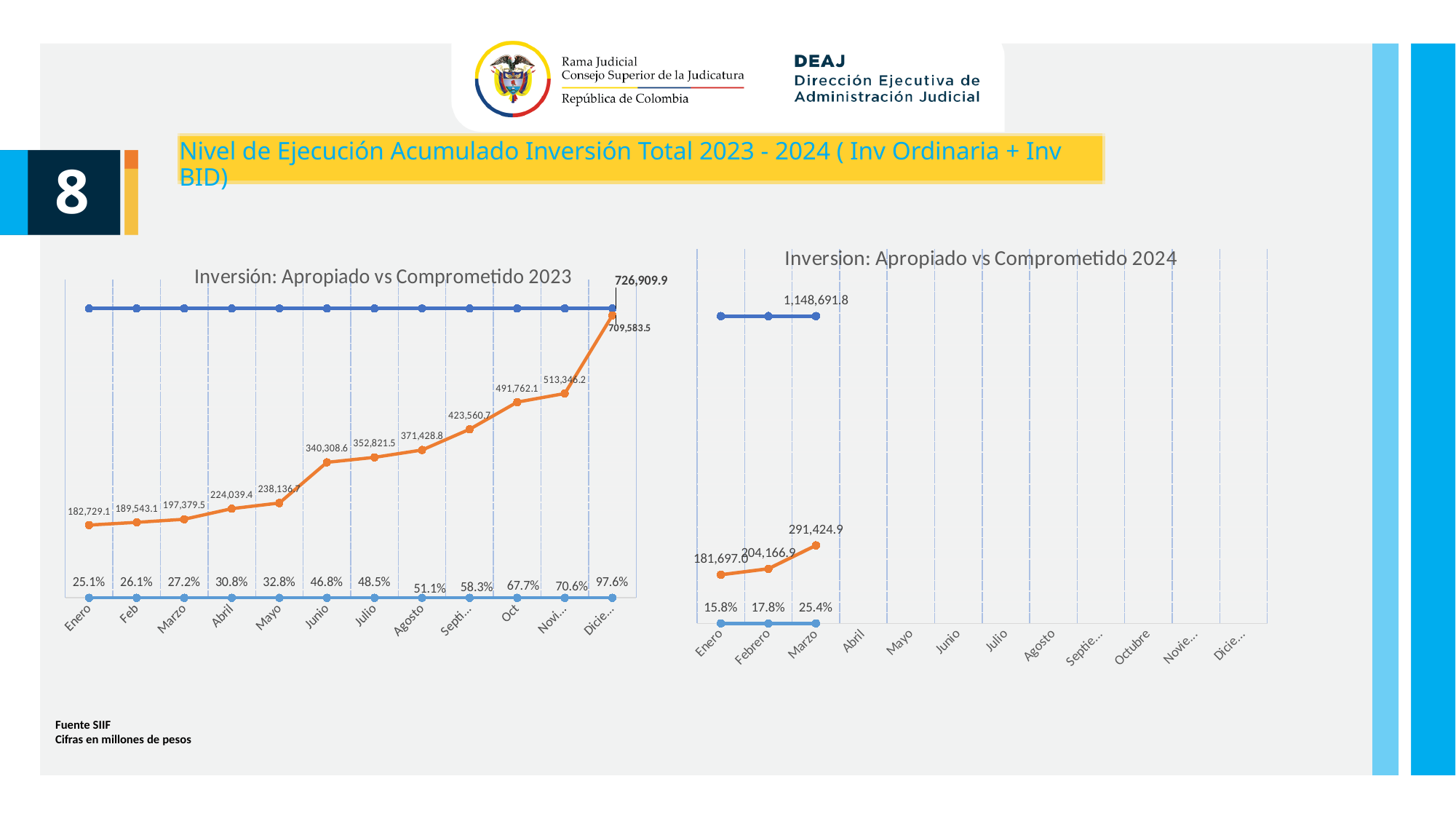
In the 'Inversión: Apropiado vs Comprometido 2023' chart, which month has the lowest value on the orange line? Enero In the 'Inversión: Apropiado vs Comprometido 2023' chart, what is the value labelled at the top of the blue line in December? 726,909.9 What type of chart is the 'Inversión: Apropiado vs Comprometido 2023' chart? Line chart In the 'Inversion: Apropiado vs Comprometido 2024' chart, what is the value of the orange line for Marzo? 291,424.9 In the 'Inversion: Apropiado vs Comprometido 2024' chart, what percentage is shown for Febrero? 17.8% In the 'Inversion: Apropiado vs Comprometido 2024' chart, what value is labelled on the blue line? 1,148,691.8 In the 'Inversión: Apropiado vs Comprometido 2023' chart, what is the value of the orange line for Junio? 340,308.6 In the 'Inversión: Apropiado vs Comprometido 2023' chart, what percentage is shown for Oct? 67.7% In the 'Inversión: Apropiado vs Comprometido 2023' chart, does the orange line rise or fall from Enero to Dicie...? Rise In the 'Inversión: Apropiado vs Comprometido 2023' chart, what is the difference between the orange line values for Feb and Enero? 6,814.0 How many months are plotted on the orange line in the 'Inversión: Apropiado vs Comprometido 2023' chart? 12 In the 'Inversion: Apropiado vs Comprometido 2024' chart, which is larger: the orange line value for Enero or for Marzo? Marzo